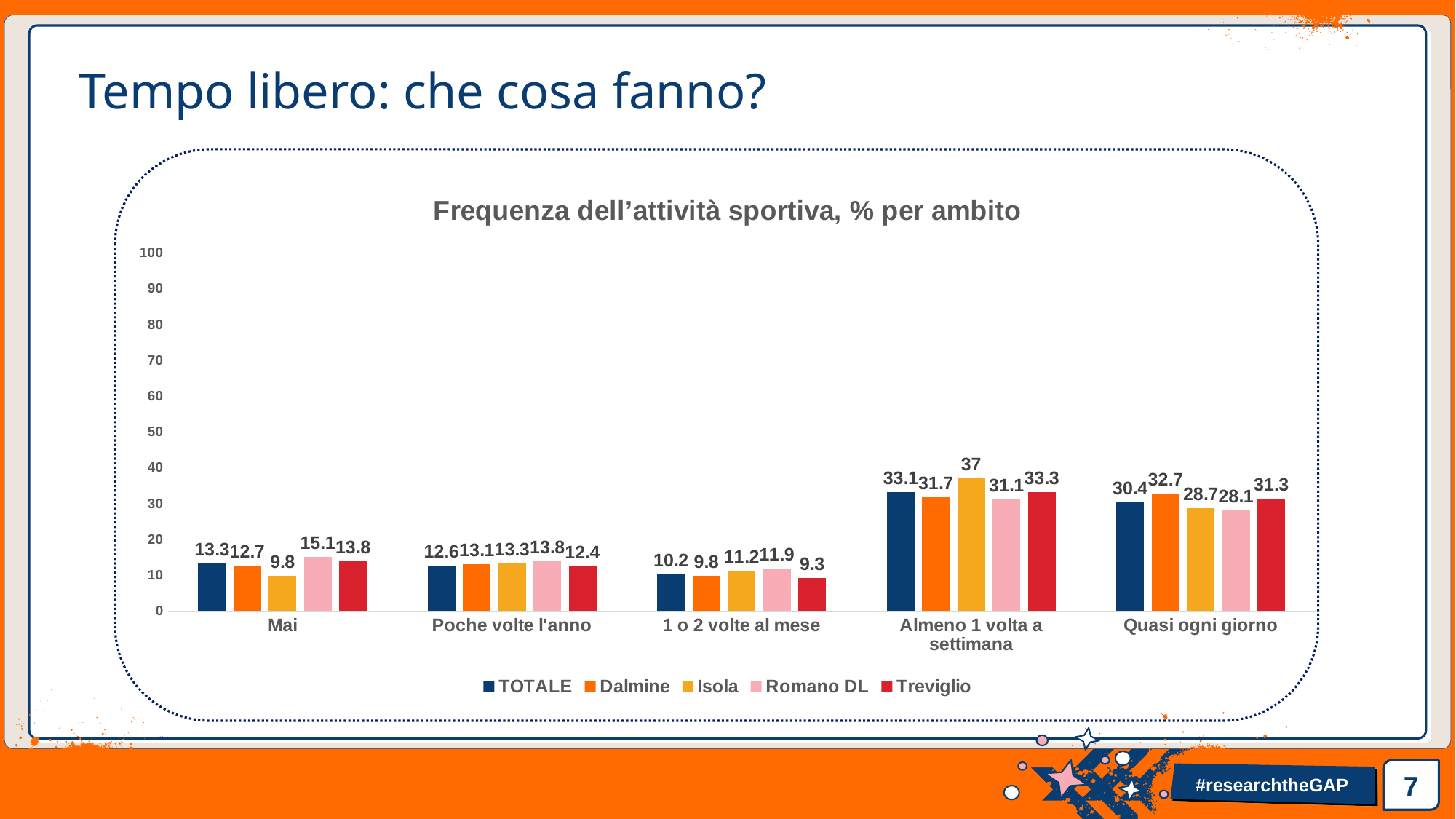
Which series has the lowest value in the '1 o 2 volte al mese' category? Treviglio Which series has the highest value in the 'Almeno 1 volta a settimana' category? Isola What is the TOTALE value for 'Quasi ogni giorno'? 30.4 How many categories are shown on the x axis? 5 What is the value for Romano DL in the 'Mai' category? 15.1 What is the difference between the Dalmine and Isola values in the 'Quasi ogni giorno' category? 4 How many series does the legend list? 5 Is the Isola value for 'Almeno 1 volta a settimana' greater or less than 30? greater What is the value for Isola in the 'Almeno 1 volta a settimana' category? 37 Which is larger in the 'Mai' category: the value for Dalmine or the value for Treviglio? Treviglio What kind of chart is shown on the slide? Bar chart What is the title of the chart? Frequenza dell'attività sportiva, % per ambito